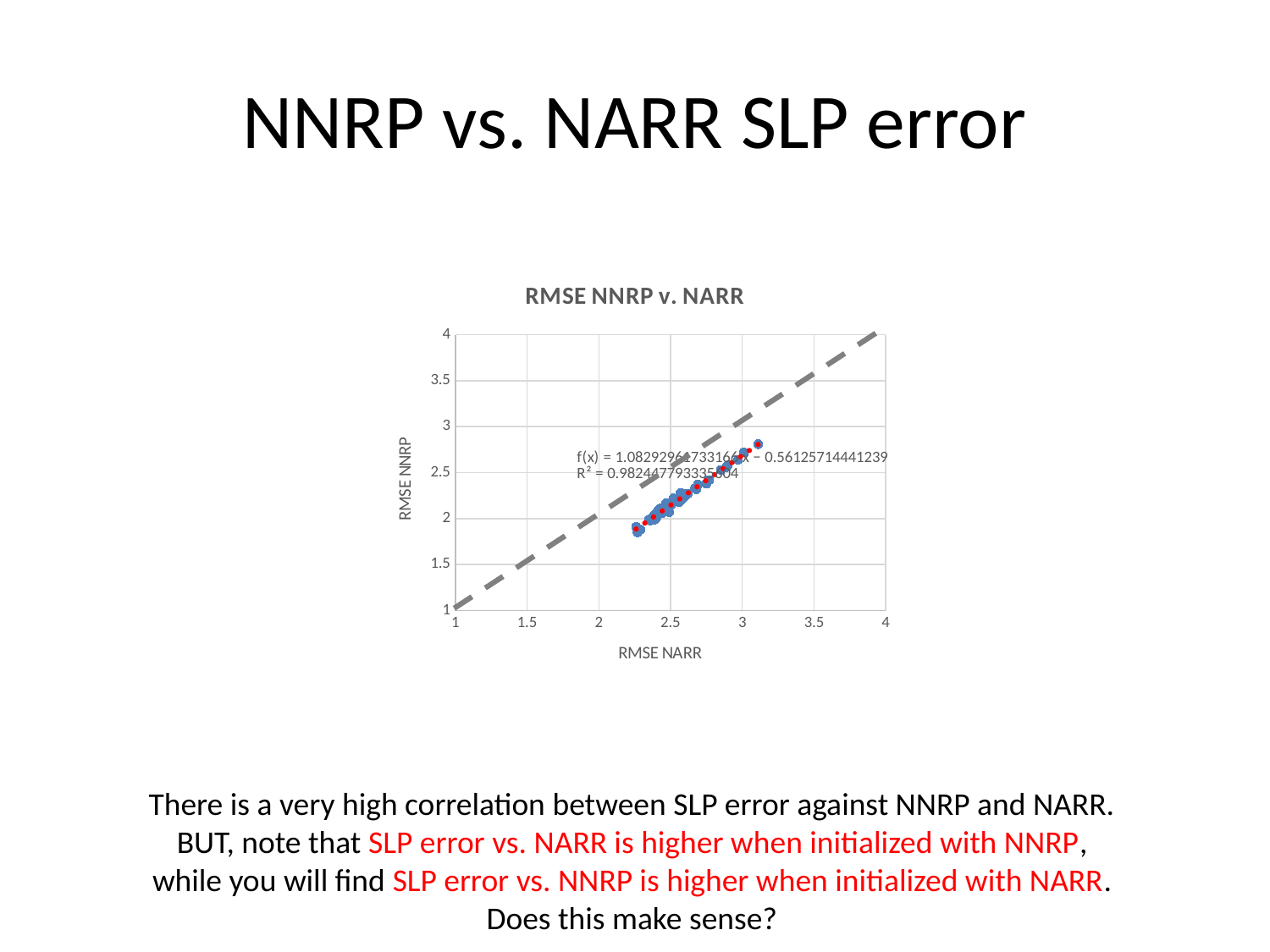
Is the lowest RMSE NNRP value among the plotted points greater or less than 1.5? greater What is the label of the horizontal axis of the chart? RMSE NARR Is the highest RMSE NARR value among the plotted points greater or less than 3.5? less What kind of chart is shown on the slide? Scatter chart Is the lowest RMSE NARR value among the plotted points greater or less than 2? greater What is the minimum value shown on the horizontal axis of the chart? 1 As RMSE NARR increases along the x axis, do the RMSE NNRP values rise or fall? Rise What is the title of the chart? RMSE NNRP v. NARR What is the maximum value shown on the vertical axis of the chart? 4